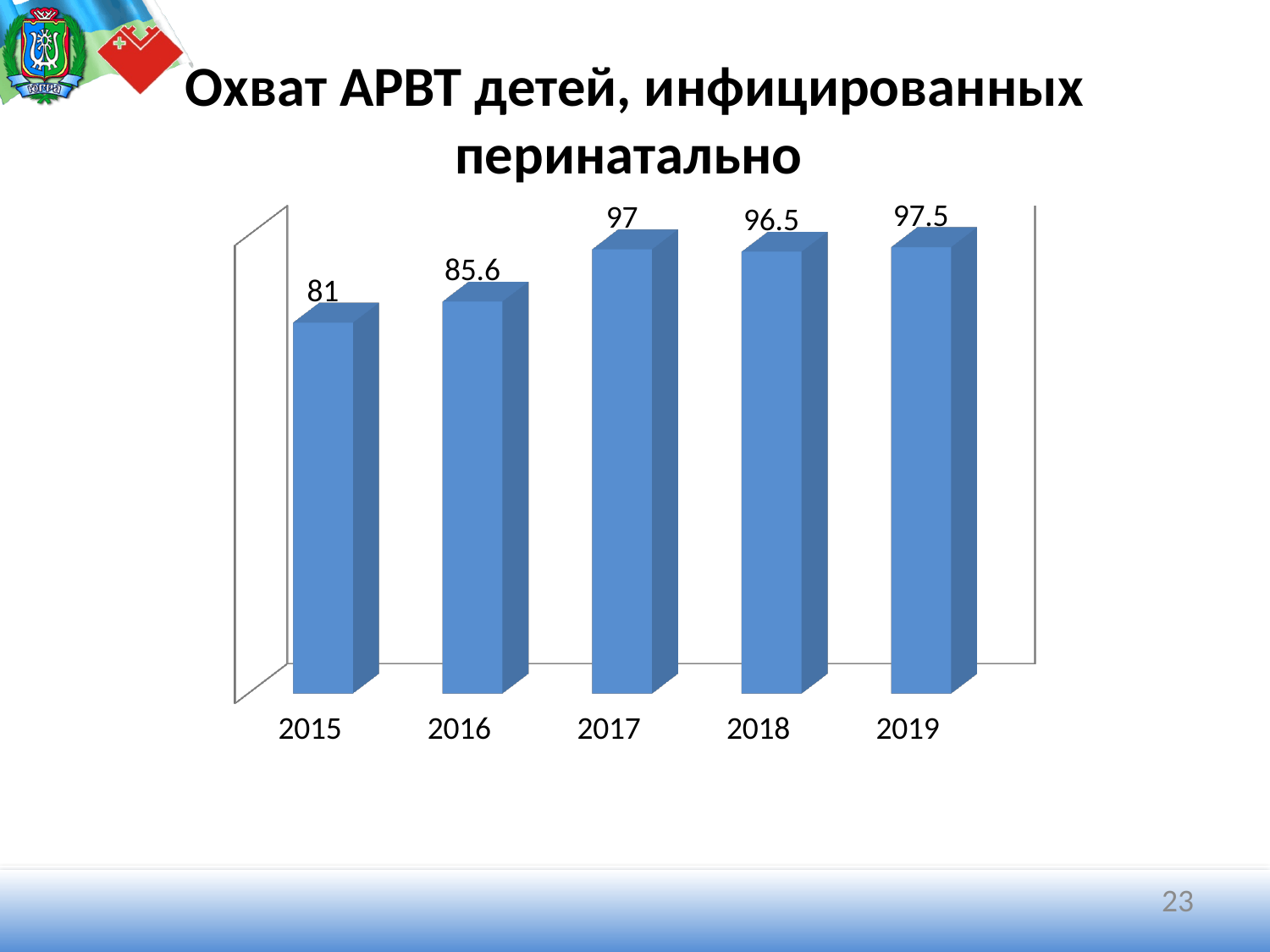
Which is larger, the value for 2016 or the value for 2018? 2018 What kind of chart is shown on the slide? Bar chart What is the value for 2019? 97.5 What is the difference between the values for 2019 and 2015? 16.5 What is the value for 2018? 96.5 How many years are shown on the x axis? 5 What is the value for 2015? 81 What is the value for 2016? 85.6 Which year has the highest value? 2019 What is the title of the chart? Охват АРВТ детей, инфицированных перинатально Which year has the lowest value? 2015 What is the value for 2017? 97